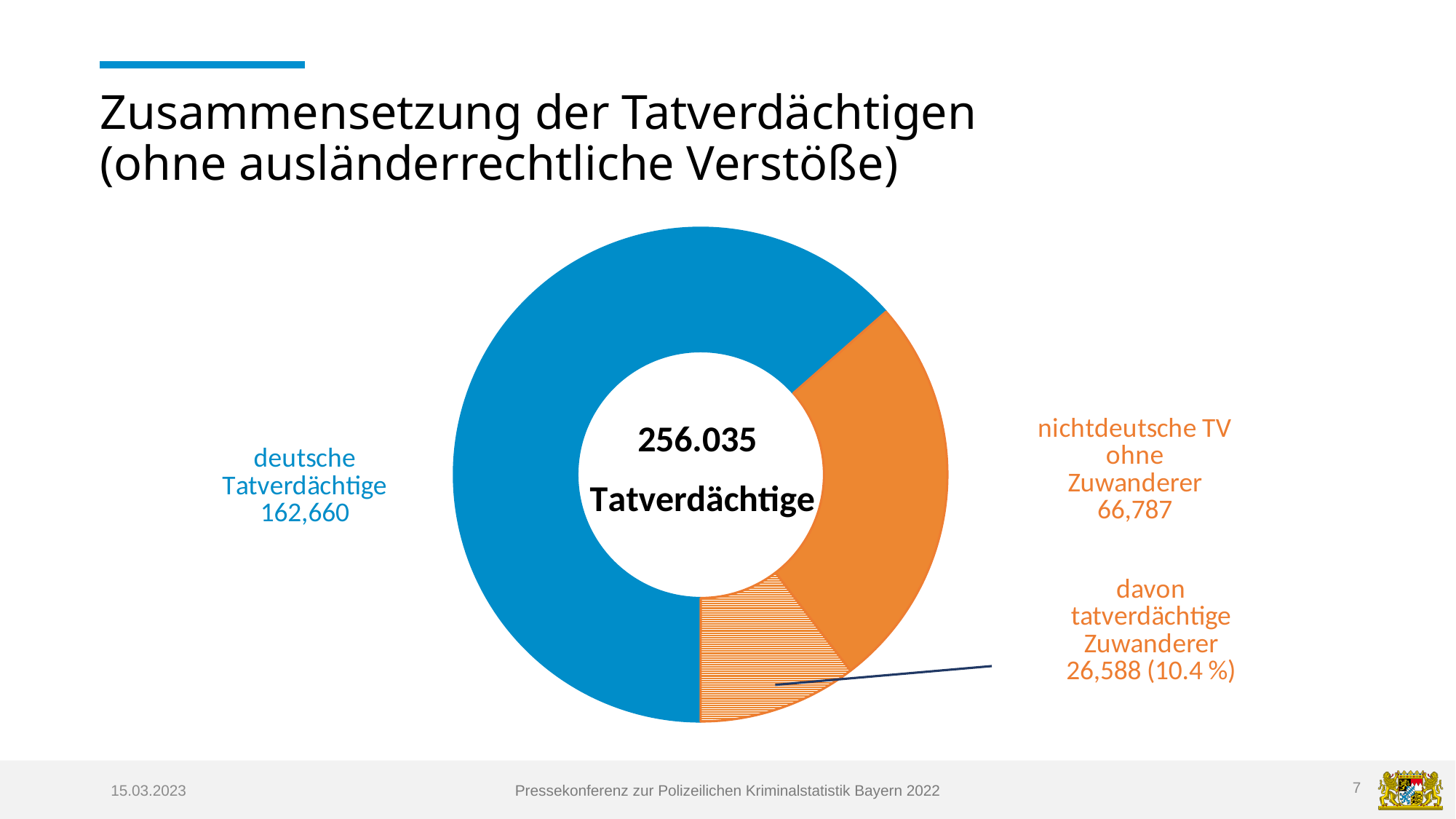
How many segments does the chart have? 3 Which segment of the chart is the largest? deutsche Tatverdächtige Which segment of the chart is the smallest? tatverdächtige Zuwanderer What is the difference between nichtdeutsche TV ohne Zuwanderer and tatverdächtige Zuwanderer? 40,199 What is the value for nichtdeutsche TV ohne Zuwanderer? 66,787 Which is larger: nichtdeutsche TV ohne Zuwanderer or tatverdächtige Zuwanderer? nichtdeutsche TV ohne Zuwanderer What type of chart is shown on the slide? Pie chart (donut) What total number of Tatverdächtige is shown in the centre of the chart? 256.035 What is the value for deutsche Tatverdächtige? 162,660 What share of all Tatverdächtige do the tatverdächtige Zuwanderer make up? 10.4 % What is the value for tatverdächtige Zuwanderer? 26,588 What is the difference between deutsche Tatverdächtige and nichtdeutsche TV ohne Zuwanderer? 95,873